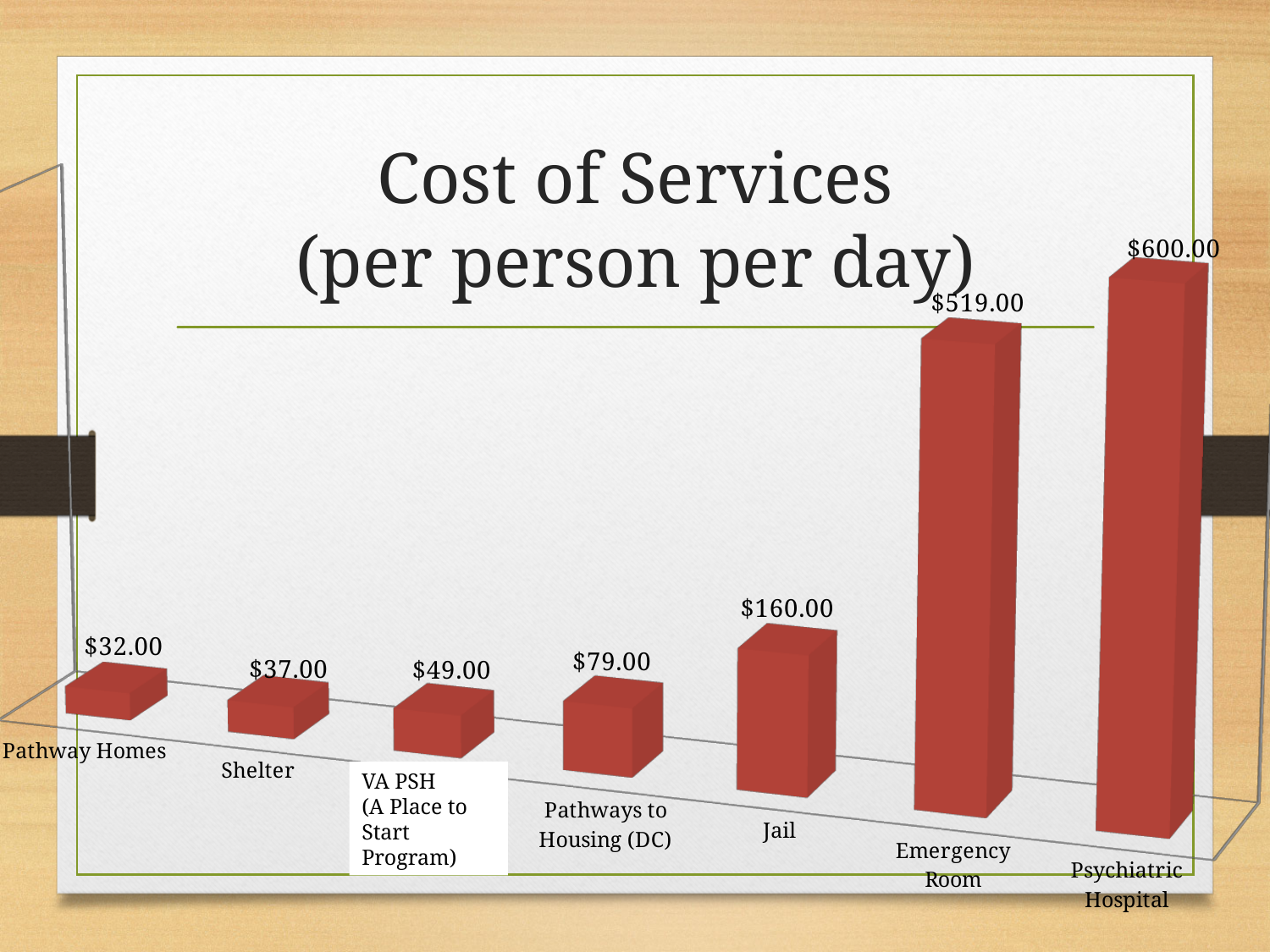
What kind of chart is shown on the slide? Bar chart How many categories are shown in the chart? 7 What is the difference in cost between Psychiatric Hospital and Emergency Room? $81.00 Which category has the highest cost per person per day? Psychiatric Hospital What is the cost per person per day for Pathway Homes? $32.00 What is the cost per person per day for VA PSH (A Place to Start Program)? $49.00 What is the cost per person per day for the Emergency Room? $519.00 Which category has the lowest cost per person per day? Pathway Homes What is the difference in cost between Jail and Pathways to Housing (DC)? $81.00 What is the title of the chart? Cost of Services (per person per day) Which has a higher cost per person per day, Shelter or Pathways to Housing (DC)? Pathways to Housing (DC) What is the cost per person per day for Jail? $160.00